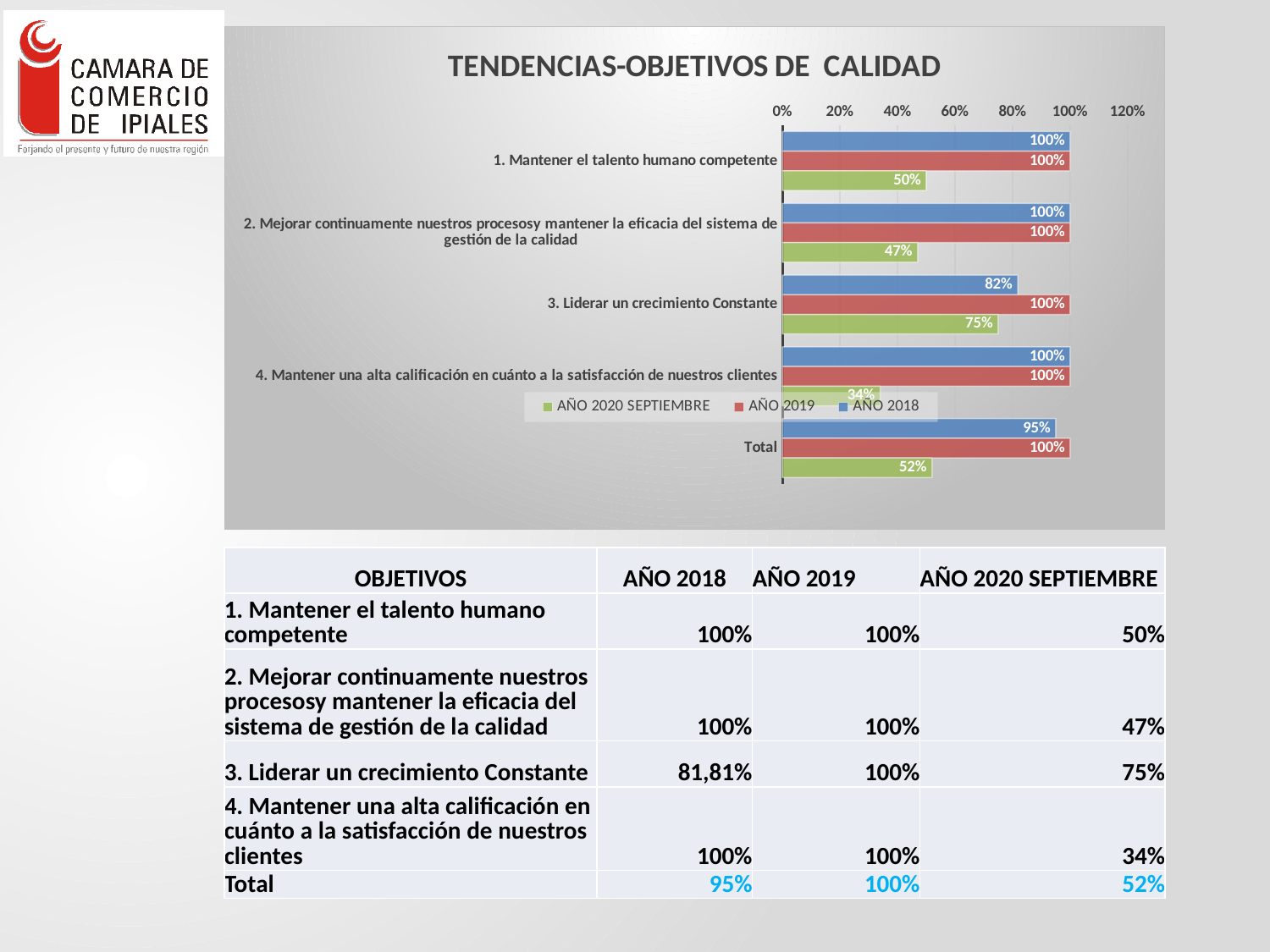
What type of chart is shown on the slide? bar chart What is the AÑO 2020 SEPTIEMBRE value for '1. Mantener el talento humano competente'? 50% For 'Total', which is larger: the AÑO 2018 value or the AÑO 2020 SEPTIEMBRE value? AÑO 2018 What is the difference between the AÑO 2019 and AÑO 2020 SEPTIEMBRE values for '2. Mejorar continuamente nuestros procesosy mantener la eficacia del sistema de gestión de la calidad'? 53% Which category has the lowest AÑO 2020 SEPTIEMBRE value? 4. Mantener una alta calificación en cuánto a la satisfacción de nuestros clientes How many categories are plotted on the chart? 5 What is the AÑO 2018 value for '3. Liderar un crecimiento Constante' as labelled on the chart? 82% How many series does the chart legend list? 3 What is the AÑO 2020 SEPTIEMBRE value for 'Total'? 52% Which colour represents the AÑO 2019 series in the chart? red Which category has the highest AÑO 2020 SEPTIEMBRE value? 3. Liderar un crecimiento Constante What is the title of the chart? TENDENCIAS-OBJETIVOS DE CALIDAD